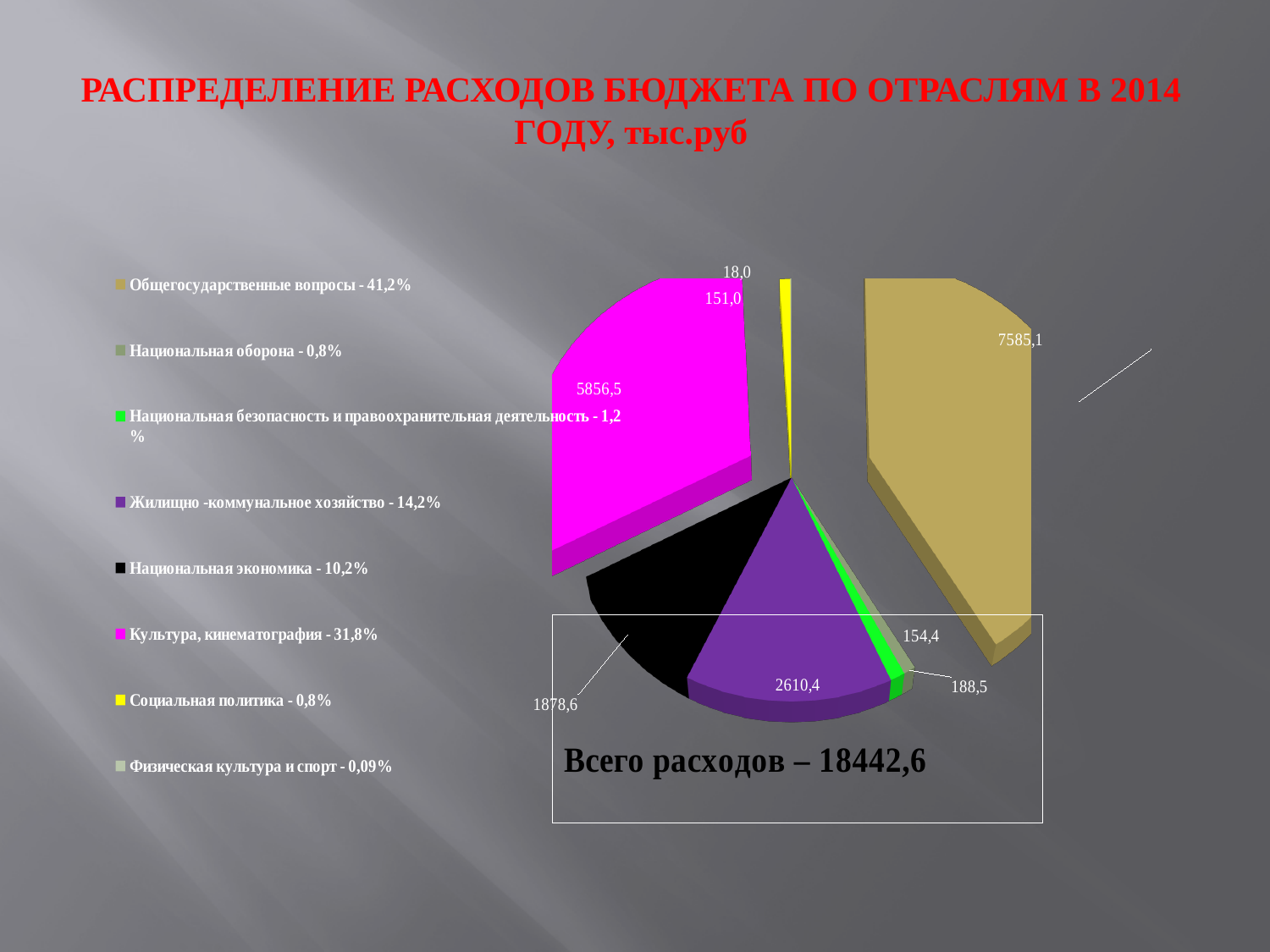
What type of chart is shown on the slide? pie chart How many categories are listed in the legend of the pie chart? 8 Which category has the smallest share of budget expenditures in the pie chart? Физическая культура и спорт What is the value (тыс.руб) for Жилищно-коммунальное хозяйство? 2610,4 What is the value (тыс.руб) for Национальная экономика? 1878,6 What total expenditure amount is stated on the slide? 18442,6 What is the difference between the values for Общегосударственные вопросы and Культура, кинематография? 1728,6 Which category has the largest share of budget expenditures in the pie chart? Общегосударственные вопросы What share of the budget expenditures does Культура, кинематография account for? 31,8% What is the value (тыс.руб) for Культура, кинематография? 5856,5 What share of the budget expenditures does Жилищно-коммунальное хозяйство account for? 14,2% What is the value (тыс.руб) for Общегосударственные вопросы? 7585,1